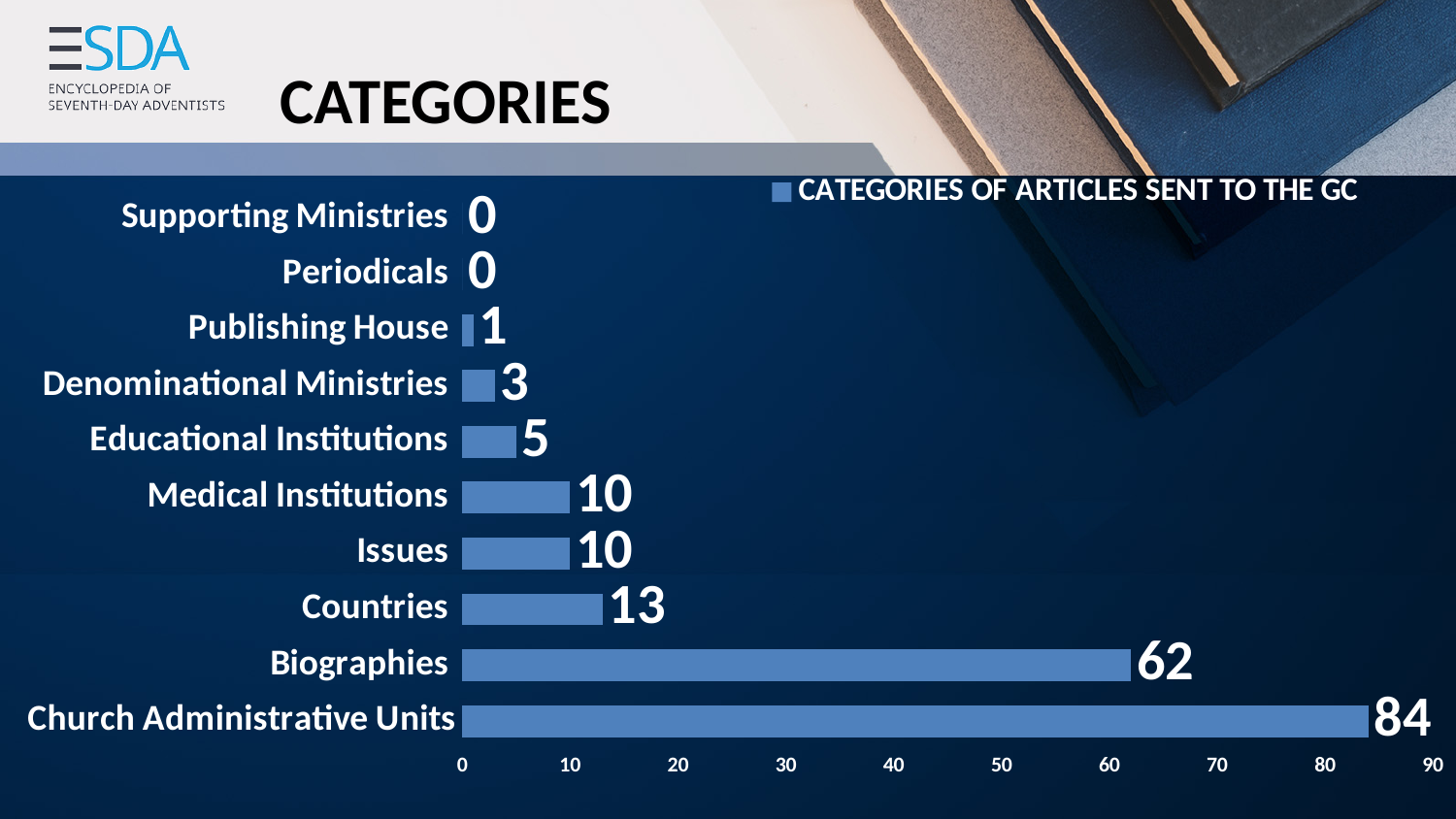
What is the value for Countries? 13 What is the value for Biographies? 62 How many series does the legend list? 1 How many categories are shown in the chart? 10 Is the value for Biographies greater or less than 50? greater What is the value for Educational Institutions? 5 What is the legend entry for the series? CATEGORIES OF ARTICLES SENT TO THE GC What kind of chart is shown? bar chart What is the value for Church Administrative Units? 84 What is the difference between Church Administrative Units and Biographies? 22 Which is larger, Countries or Medical Institutions? Countries Which category has the highest value? Church Administrative Units